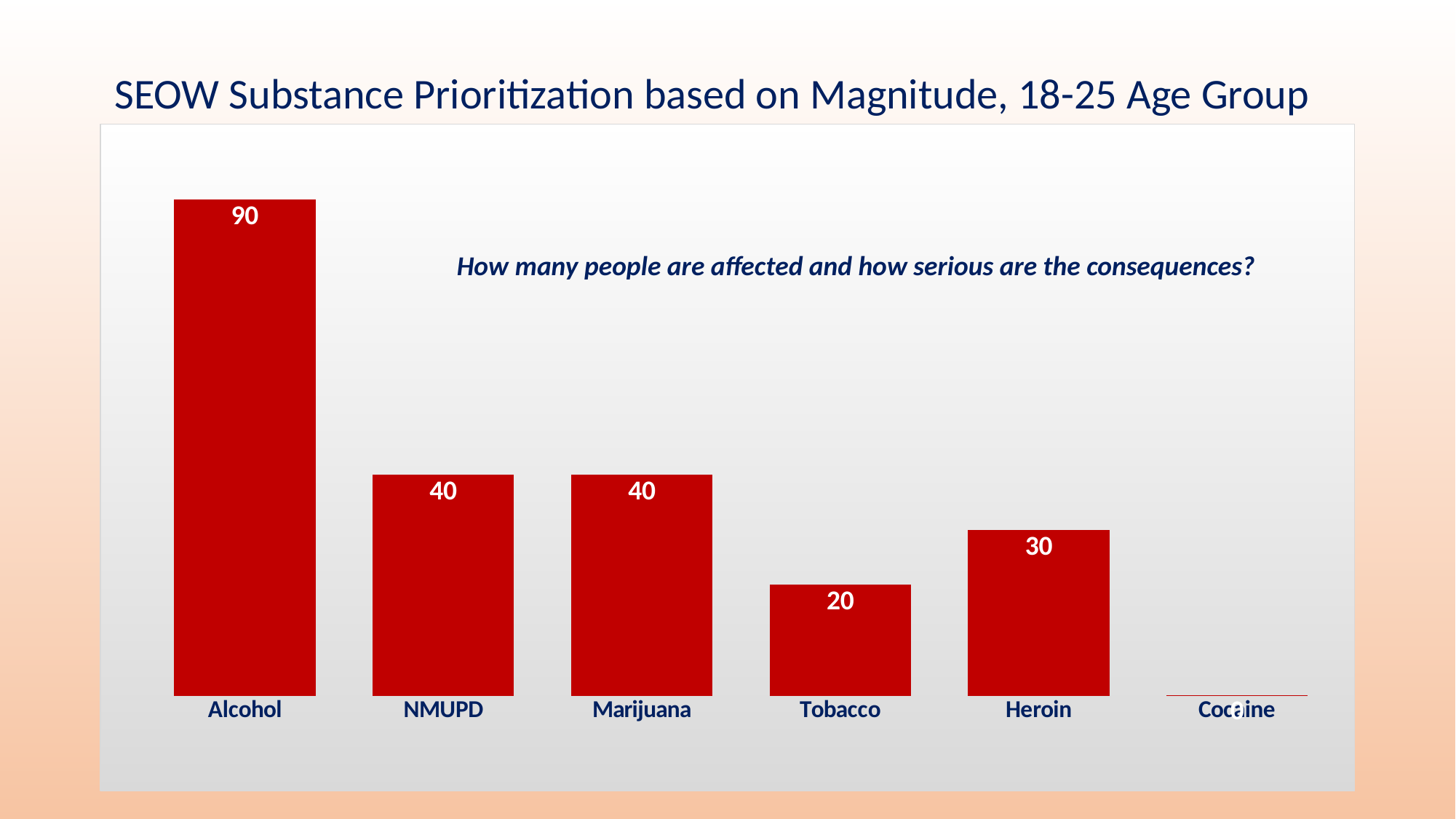
What kind of chart is shown on the slide? Bar chart How many substances are shown on the x axis? 6 What is the difference between the values for Heroin and Tobacco? 10 Which substance has the lowest value? Cocaine What is the value for NMUPD? 40 What is the title of the slide? SEOW Substance Prioritization based on Magnitude, 18-25 Age Group Which substance has the highest value? Alcohol What is the value for Heroin? 30 Which is larger, the value for Heroin or the value for Tobacco? Heroin What is the value for Tobacco? 20 What is the difference between the values for Alcohol and Marijuana? 50 What is the value for Alcohol? 90